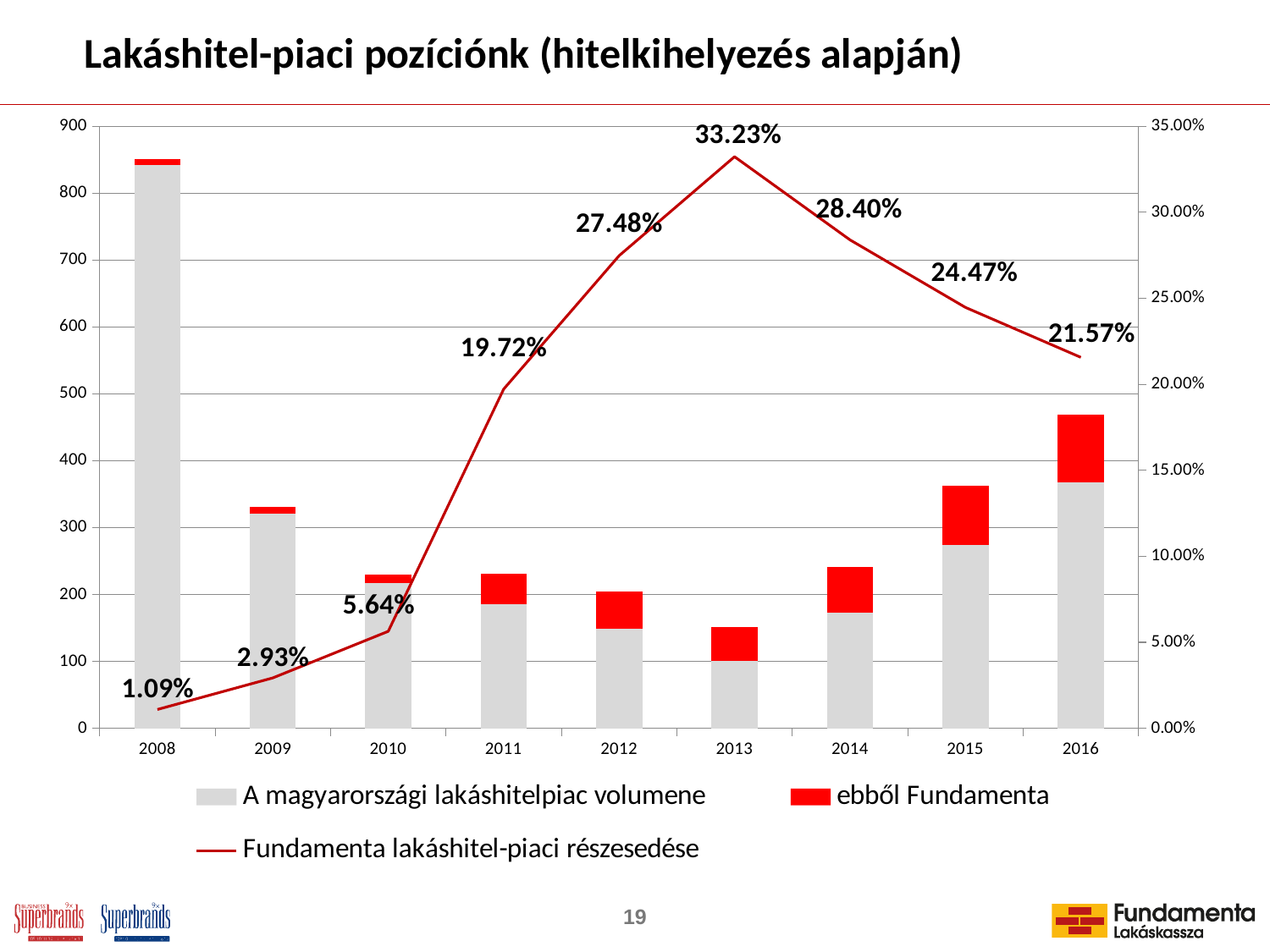
Is the total height of the stacked bar for 2008 greater or less than 800? greater What was Fundamenta's housing-loan market share (Fundamenta lakáshitel-piaci részesedése) in 2013? 33.23% What kind of chart is shown on the slide? Combination of a stacked bar chart and a line chart Which year had the larger Fundamenta market share, 2014 or 2015? 2014 How many years are shown on the x axis? 9 What was Fundamenta's market share in 2008 according to the line label? 1.09% By how many percentage points did Fundamenta's market share fall from 2013 to 2016? 11.66 percentage points In which year was Fundamenta's market share the highest? 2013 How many series does the legend list? 3 In which year was Fundamenta's market share the lowest? 2008 Does Fundamenta's market share rise or fall from 2008 to 2013? rise Is the total height of the stacked bar for 2013 greater or less than 200? less